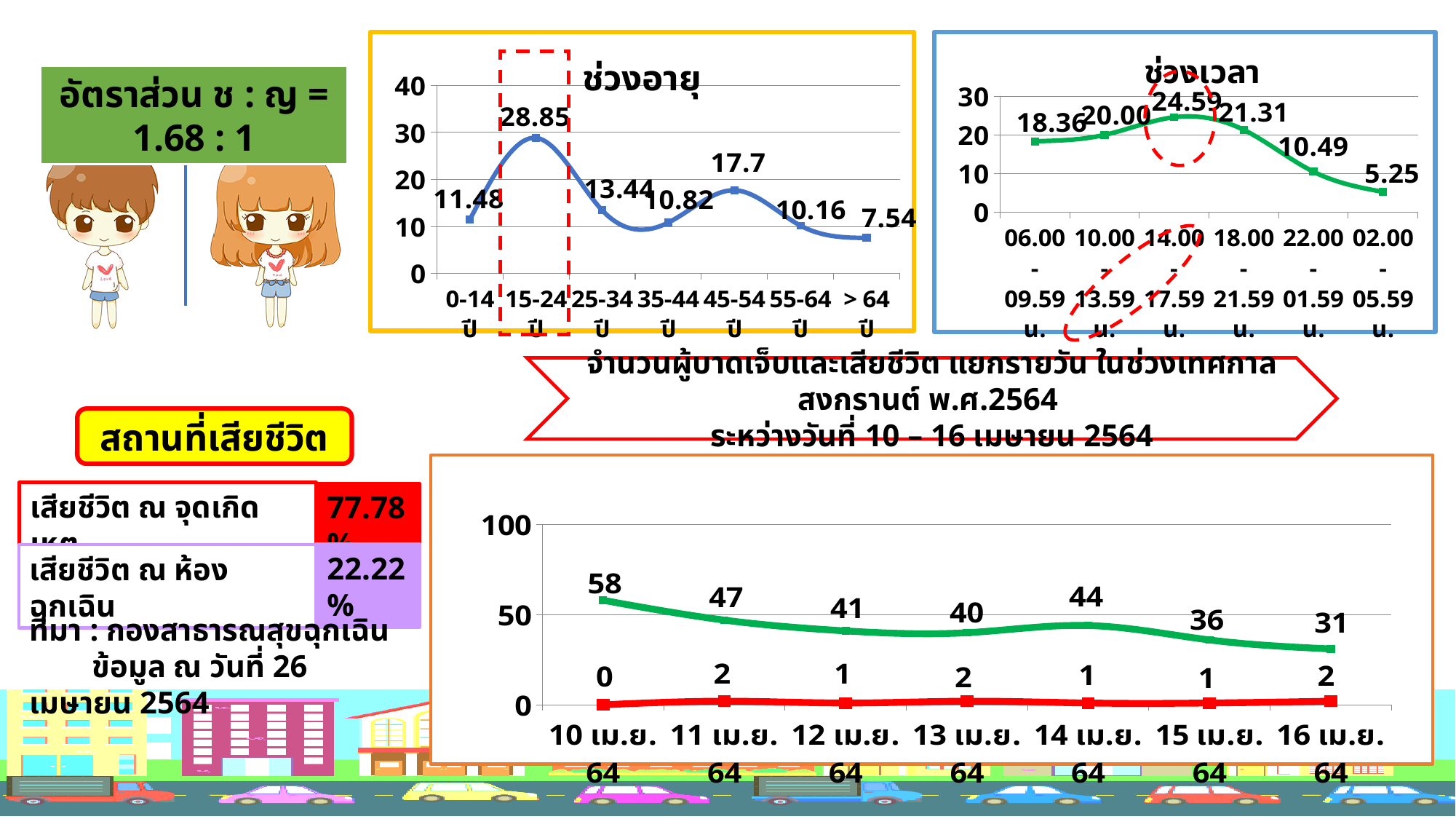
In the ช่วงอายุ chart, what is the value for the 15-24 ปี age group? 28.85 In the bottom chart (จำนวนผู้บาดเจ็บและเสียชีวิต แยกรายวัน), on which date does the green line reach its lowest value? 16 เม.ย. 64 In the ช่วงเวลา chart, what is the value for the 14.00-17.59 น. time period? 24.59 In the ช่วงอายุ chart, how many age groups are plotted? 7 In the bottom chart (จำนวนผู้บาดเจ็บและเสียชีวิต แยกรายวัน), what is the value of the green line on 10 เม.ย. 64? 58 In the bottom chart (จำนวนผู้บาดเจ็บและเสียชีวิต แยกรายวัน), what is the value of the red line on 13 เม.ย. 64? 2 What type of chart is the ช่วงเวลา chart? line chart In the bottom chart (จำนวนผู้บาดเจ็บและเสียชีวิต แยกรายวัน), what is the difference between the green line values on 10 เม.ย. 64 and 11 เม.ย. 64? 11 In the ช่วงเวลา chart, which time period has the lowest value? 02.00-05.59 น. In the ช่วงอายุ chart, what is the difference between the values for 45-54 ปี and 55-64 ปี? 7.54 In the ช่วงเวลา chart, which is larger: the value for 06.00-09.59 น. or for 22.00-01.59 น.? 06.00-09.59 น. In the ช่วงอายุ chart, which age group has the lowest value? > 64 ปี